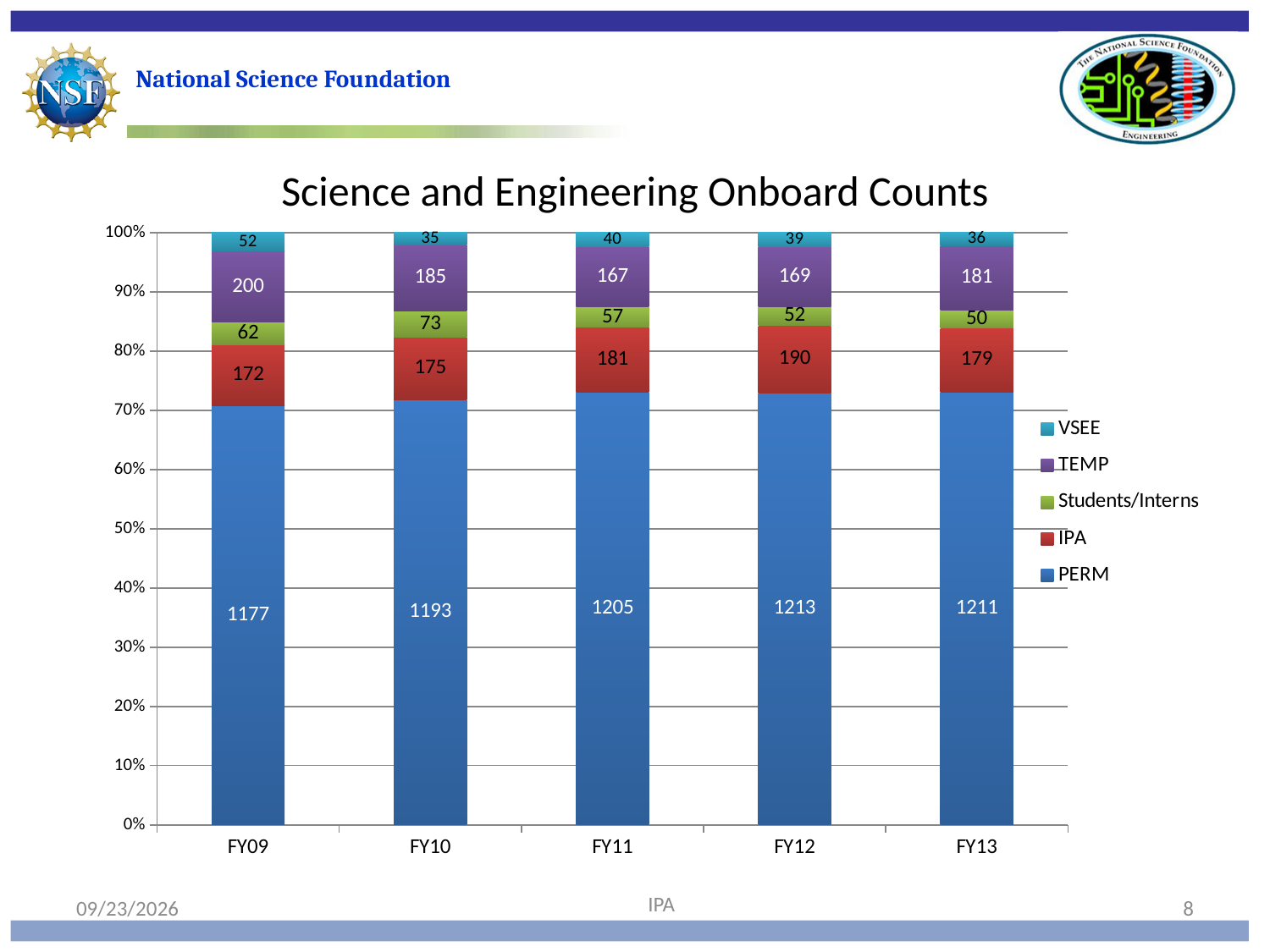
How many series does the legend list? 5 Which is larger, the TEMP value for FY10 or the TEMP value for FY13? FY10 What is the VSEE value for FY09? 52 What is the IPA value for FY12? 190 What is the total onboard count for FY09 across all five series? 1663 What is the PERM value for FY11? 1205 Which fiscal year has the lowest TEMP value? FY11 Which fiscal year has the highest PERM value? FY12 What kind of chart is shown? Stacked bar chart How many fiscal years are shown on the x axis? 5 What is the difference between the IPA values for FY12 and FY09? 18 What is the Students/Interns value for FY10? 73